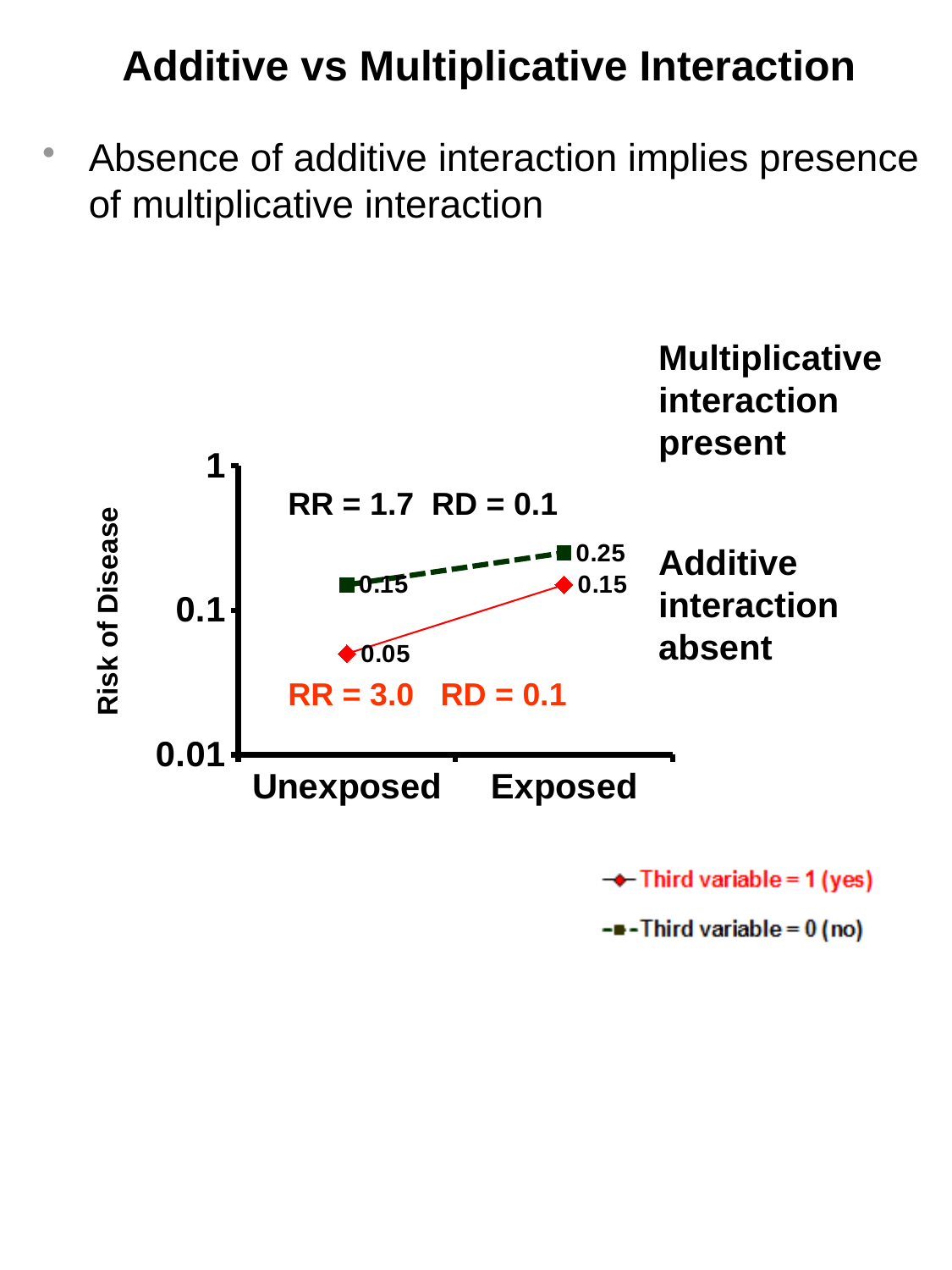
What is the risk of disease for the Exposed group when Third variable = 0 (no)? 0.25 Does the risk of disease rise or fall from Unexposed to Exposed for the Third variable = 1 (yes) series? Rise How many series does the legend list? 2 Which series has the higher risk of disease for the Unexposed group? Third variable = 0 (no) What is the difference in risk of disease between Exposed and Unexposed for the Third variable = 1 (yes) series? 0.1 What is the difference in risk of disease between Exposed and Unexposed for the Third variable = 0 (no) series? 0.1 What kind of chart is shown on the slide? Line chart What is the risk of disease for the Unexposed group when Third variable = 0 (no)? 0.15 Is the risk of disease for the Exposed group with Third variable = 0 (no) greater or less than 0.1? greater What is the risk of disease for the Exposed group when Third variable = 1 (yes)? 0.15 Which point has the lowest risk of disease on the chart? Unexposed, Third variable = 1 (yes) What is the risk of disease for the Unexposed group when Third variable = 1 (yes)? 0.05